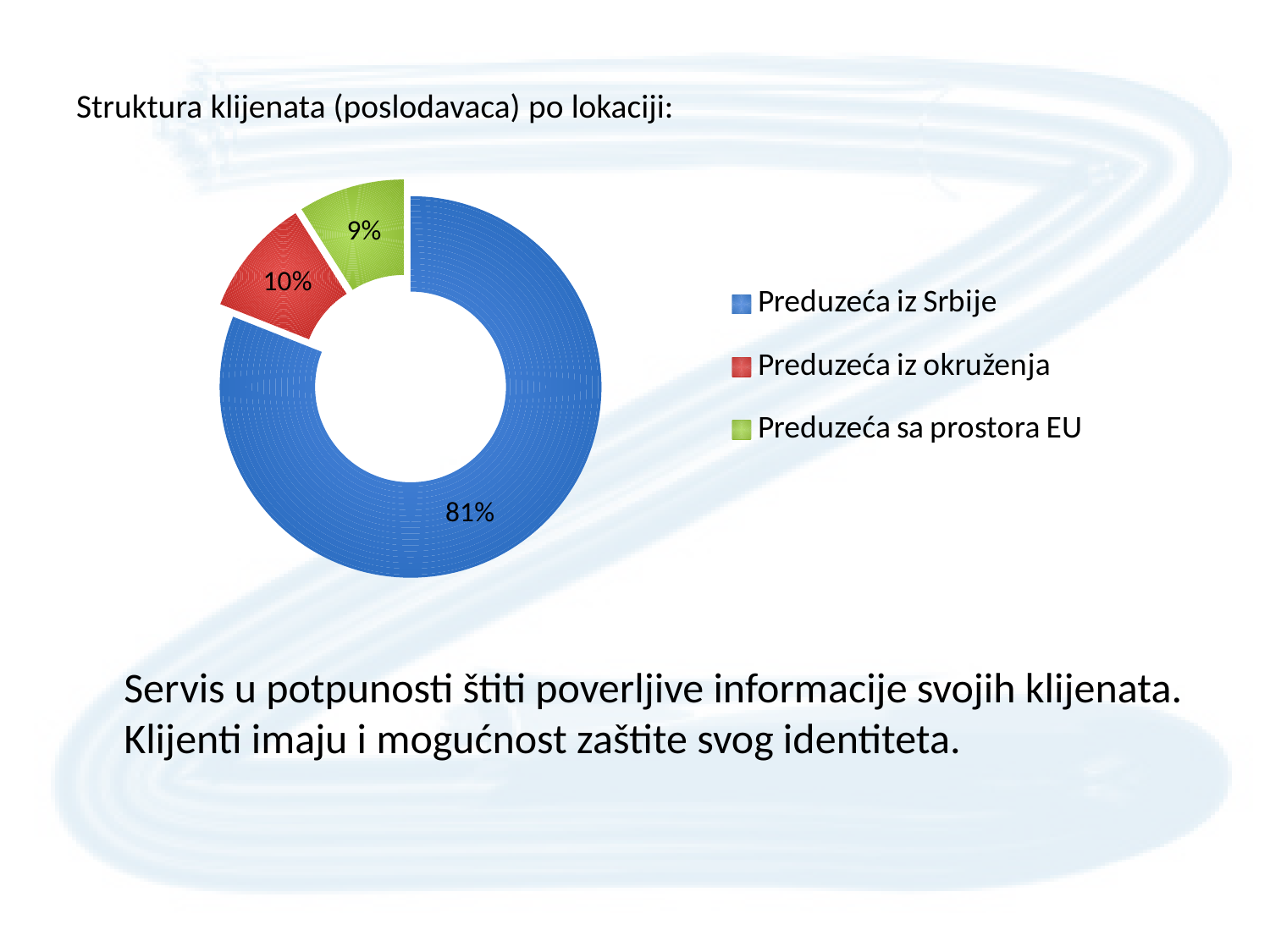
What share of the chart does Preduzeća iz Srbije represent? 81% What share of the chart does Preduzeća iz okruženja represent? 10% Which is larger, the share for Preduzeća iz Srbije or the share for Preduzeća sa prostora EU? Preduzeća iz Srbije What colour is the segment for Preduzeća iz okruženja? Red How many categories are shown in the chart? 3 What is the difference in percentage points between Preduzeća iz Srbije and Preduzeća iz okruženja? 71 What is the combined share of Preduzeća iz okruženja and Preduzeća sa prostora EU? 19% Which category has the smallest share of the chart? Preduzeća sa prostora EU What share of the chart does Preduzeća sa prostora EU represent? 9% What kind of chart is shown on the slide? Doughnut chart What is the difference in percentage points between Preduzeća iz okruženja and Preduzeća sa prostora EU? 1 Which category has the largest share of the chart? Preduzeća iz Srbije